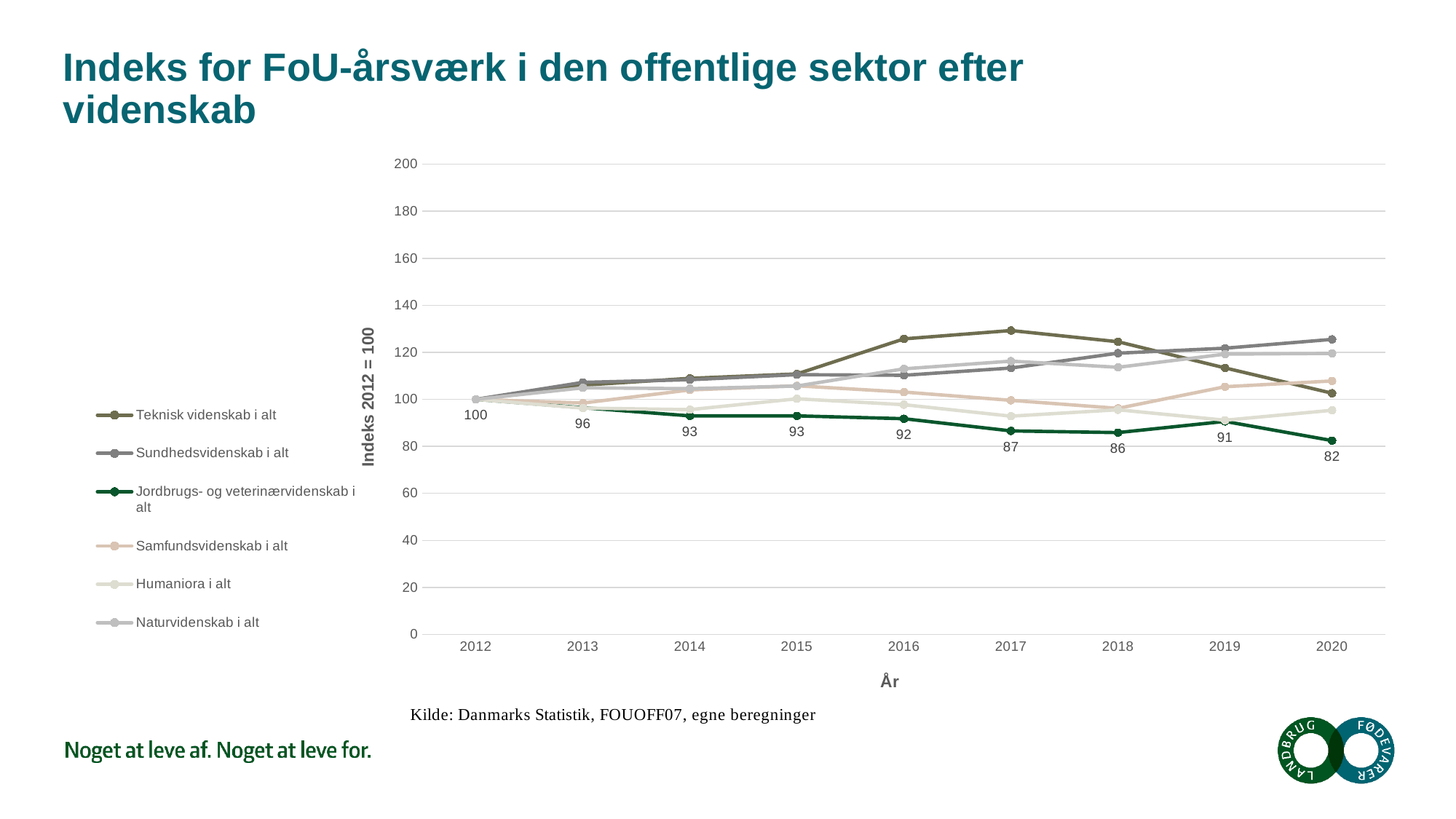
What kind of chart is shown on the slide? line chart Does the Jordbrugs- og veterinærvidenskab i alt index rise or fall from 2012 to 2020 overall? fall What is the index value for Jordbrugs- og veterinærvidenskab i alt in 2017? 87 What is the index value for Jordbrugs- og veterinærvidenskab i alt in 2020? 82 How many series does the legend list? 6 What is the index value for Jordbrugs- og veterinærvidenskab i alt in 2019? 91 What is the difference between the Jordbrugs- og veterinærvidenskab i alt index in 2012 and in 2020? 18 Which series has the highest value in 2017? Teknisk videnskab i alt Is the value for Teknisk videnskab i alt in 2017 greater or less than 120? greater What is the label of the y axis? Indeks 2012 = 100 In which year is the index for Jordbrugs- og veterinærvidenskab i alt lowest? 2020 How many years are shown on the x axis? 9